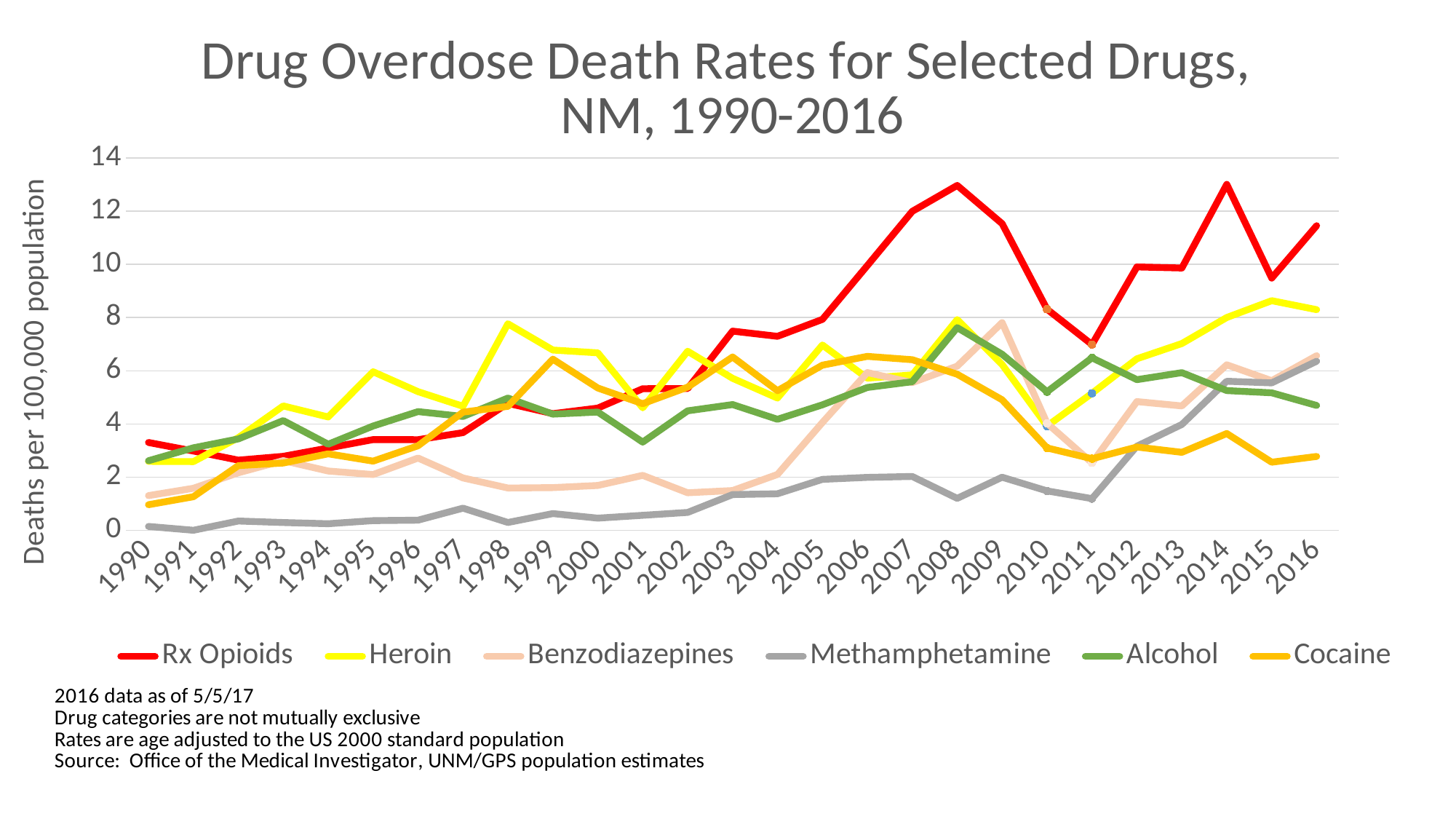
Does the Methamphetamine line rise or fall from 2011 to 2016? rise What kind of chart is shown on the slide? line chart Is the Rx Opioids value for 2008 greater or less than 12? greater How many series does the legend list? 6 For Rx Opioids, which year has the larger value: 2014 or 2015? 2014 Which drug has the lowest death rate in 2000? Methamphetamine Is the Methamphetamine value for 1990 greater or less than 2? less In 2016, which is larger: the Heroin rate or the Alcohol rate? Heroin How many years are plotted along the x axis? 27 Which drug has the highest death rate in 2008? Rx Opioids What is the label on the y axis? Deaths per 100,000 population Is the Cocaine value for 2016 greater or less than 4? less